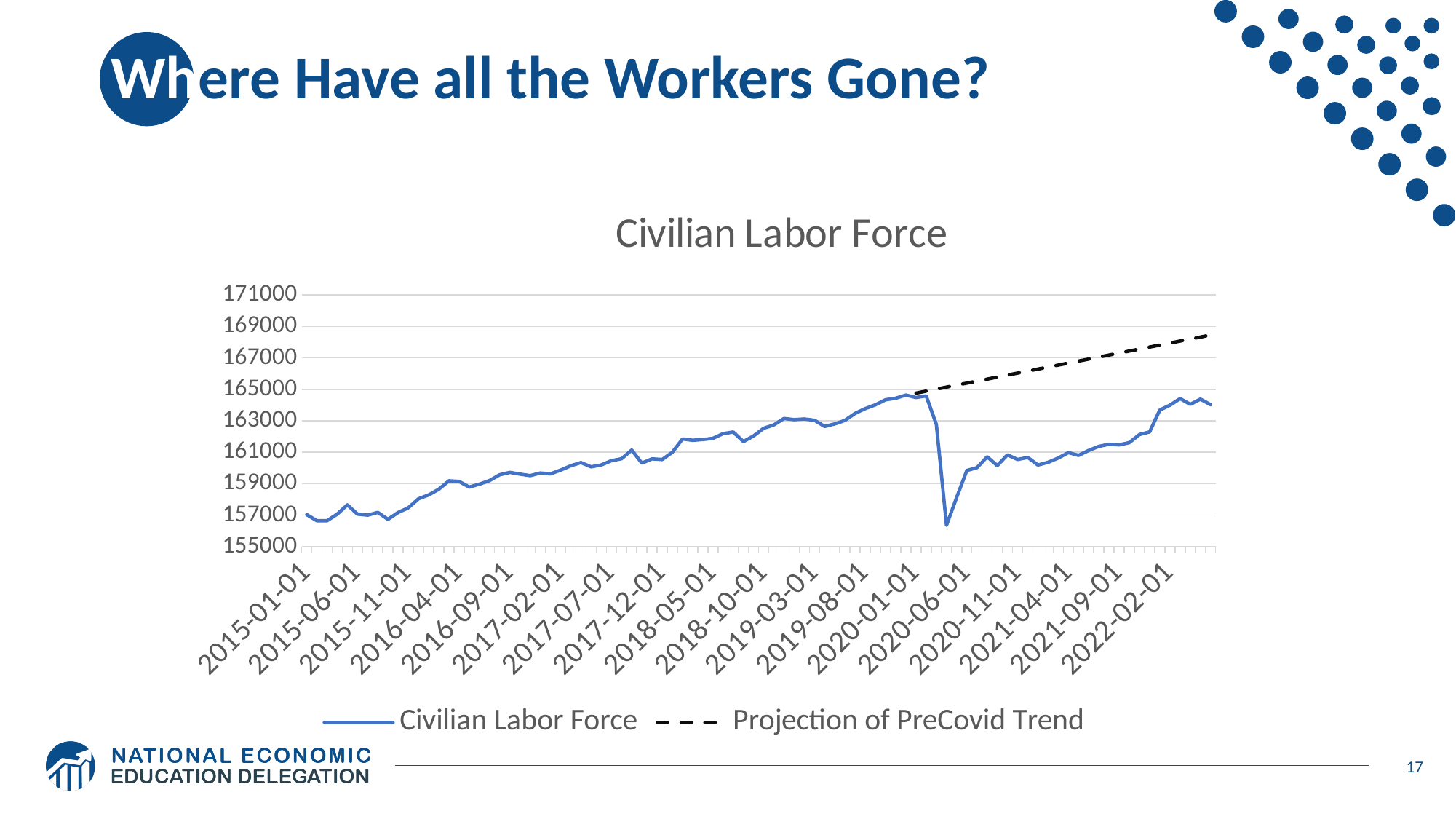
How many series does the legend list? 2 Is the value at the right end of the Projection of PreCovid Trend line greater or less than 169000? less What kind of chart is shown on the slide? line chart At the right end of the chart, which series has the higher value, Civilian Labor Force or Projection of PreCovid Trend? Projection of PreCovid Trend Which series is drawn as a dashed line? Projection of PreCovid Trend Is the Civilian Labor Force value at 2015-01-01 greater or less than 159000? less Does the Projection of PreCovid Trend line rise or fall along the x axis? rise Is the lowest point of the Civilian Labor Force line greater or less than 157000? less Does the Civilian Labor Force line generally rise or fall between 2015-01-01 and 2020-01-01? rise What is the title of the chart? Civilian Labor Force